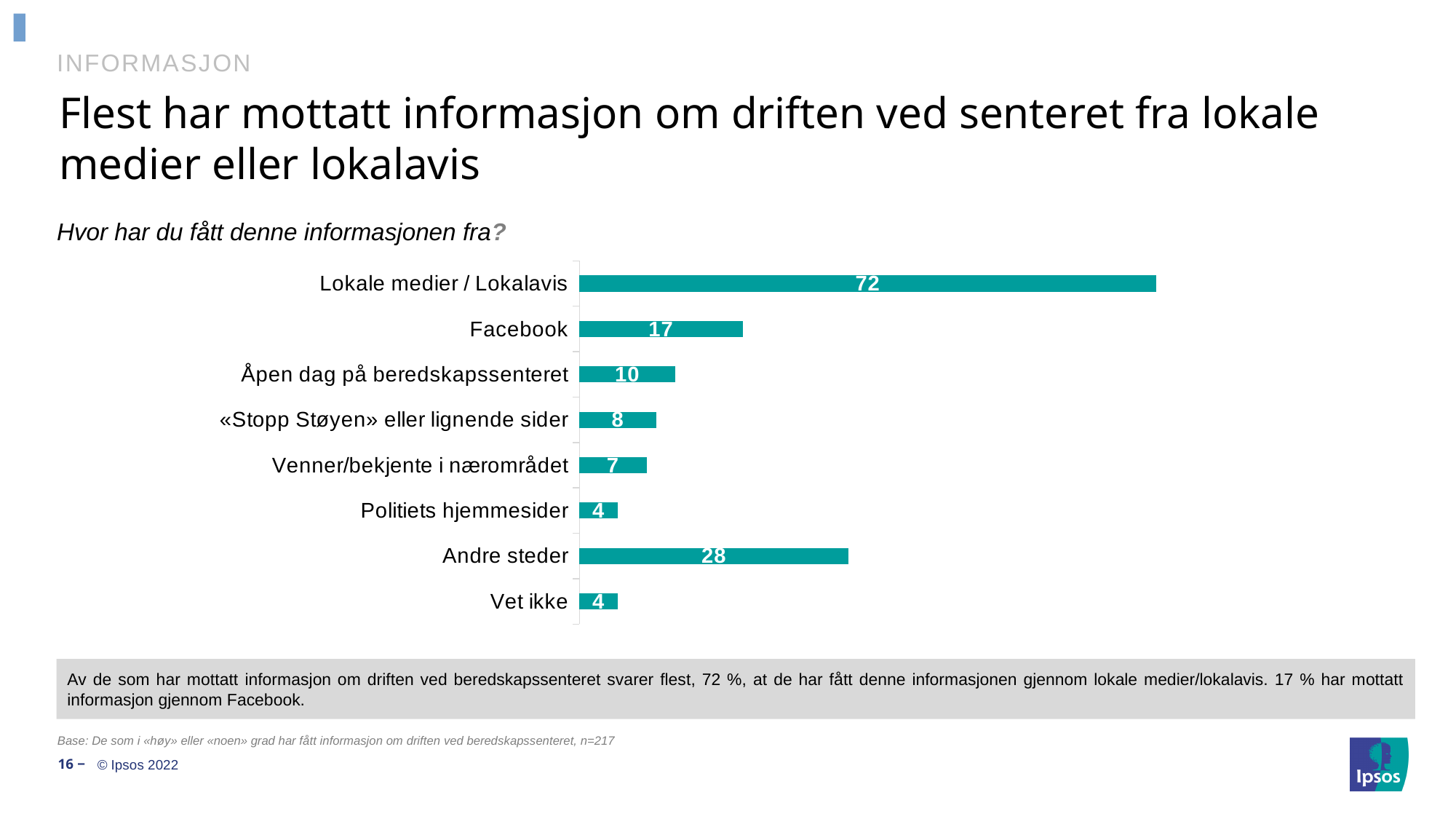
What kind of chart is shown on the slide? Bar chart What is the value for Andre steder? 28 Which is larger, the value for «Stopp Støyen» eller lignende sider or the value for Venner/bekjente i nærområdet? «Stopp Støyen» eller lignende sider What question is the chart answering, as shown above it? Hvor har du fått denne informasjonen fra? How many categories are shown in the chart? 8 What is the difference between the values for Andre steder and Facebook? 11 Which category has the highest value? Lokale medier / Lokalavis What is the difference between the values for Lokale medier / Lokalavis and Facebook? 55 What is the value for Facebook? 17 What is the value for Lokale medier / Lokalavis? 72 Which is larger, the value for Facebook or the value for Andre steder? Andre steder What is the value for Åpen dag på beredskapssenteret? 10